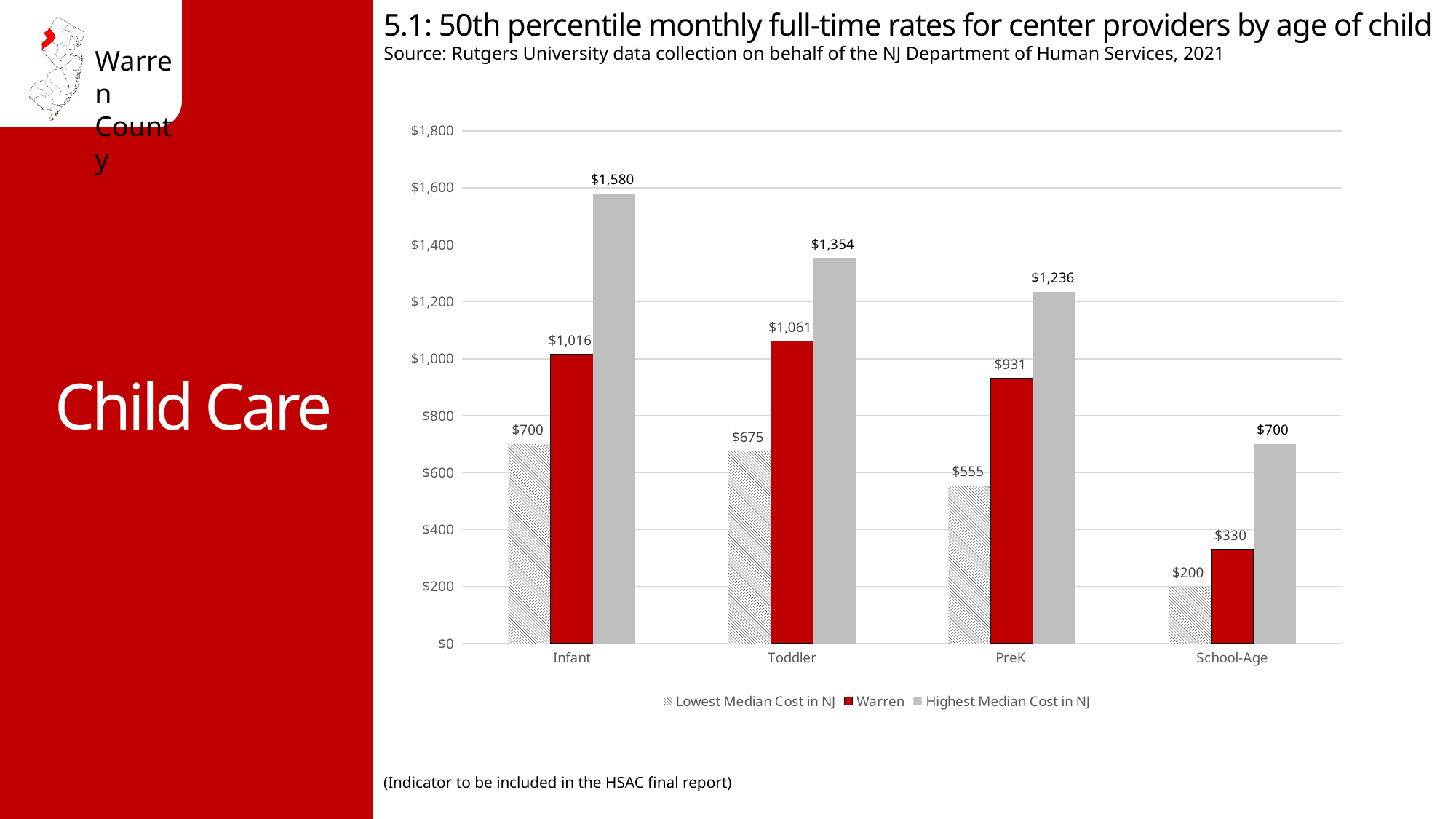
What is the Warren value for Infant? $1,016 Which age group has the highest Warren value? Toddler What is the difference between the Highest Median Cost in NJ and the Warren value for Infant? $564 Which is larger: the Warren value for PreK or the Lowest Median Cost in NJ for Infant? Warren value for PreK How many series does the legend list? 3 What kind of chart is shown? Bar chart Which age group has the lowest Highest Median Cost in NJ? School-Age What is the Highest Median Cost in NJ for Toddler? $1,354 How many age groups are shown on the x axis? 4 What is the Warren value for School-Age? $330 What is the Lowest Median Cost in NJ for PreK? $555 Do the Highest Median Cost in NJ values rise or fall from Infant to School-Age? Fall